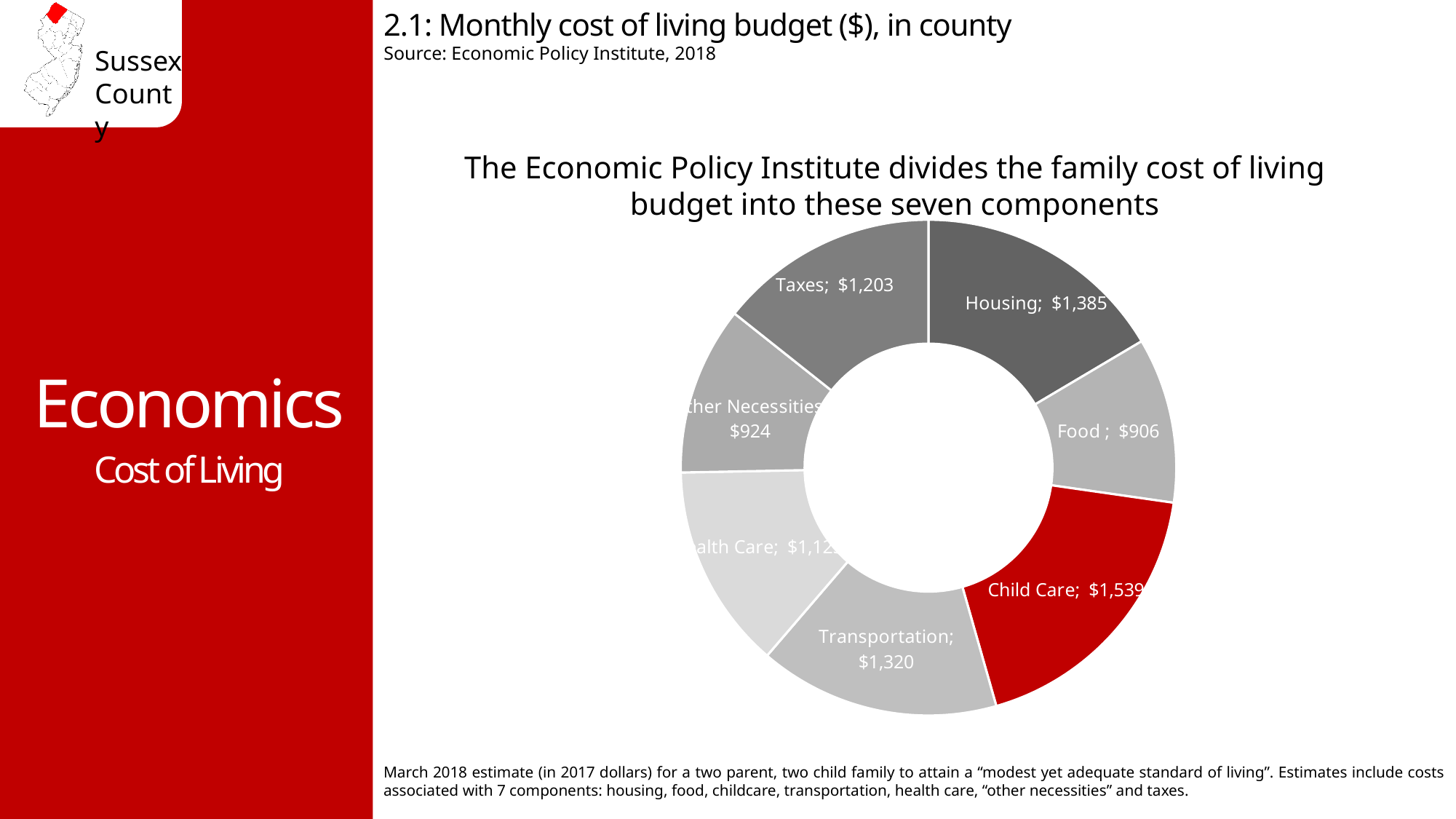
Which component has the highest monthly cost? Child Care What is the monthly cost for Taxes? $1,203 Which is larger, the monthly cost for Taxes or for Transportation? Transportation What is the monthly cost for Child Care? $1,539 How much more is the monthly cost for Child Care than for Housing? $154 What is the monthly cost for Other Necessities? $924 How many components are shown in the chart? 7 Which component has the lowest monthly cost? Food What is the monthly cost for Food? $906 What is the monthly cost for Transportation? $1,320 What is the monthly cost for Housing? $1,385 What kind of chart is shown on the slide? doughnut chart